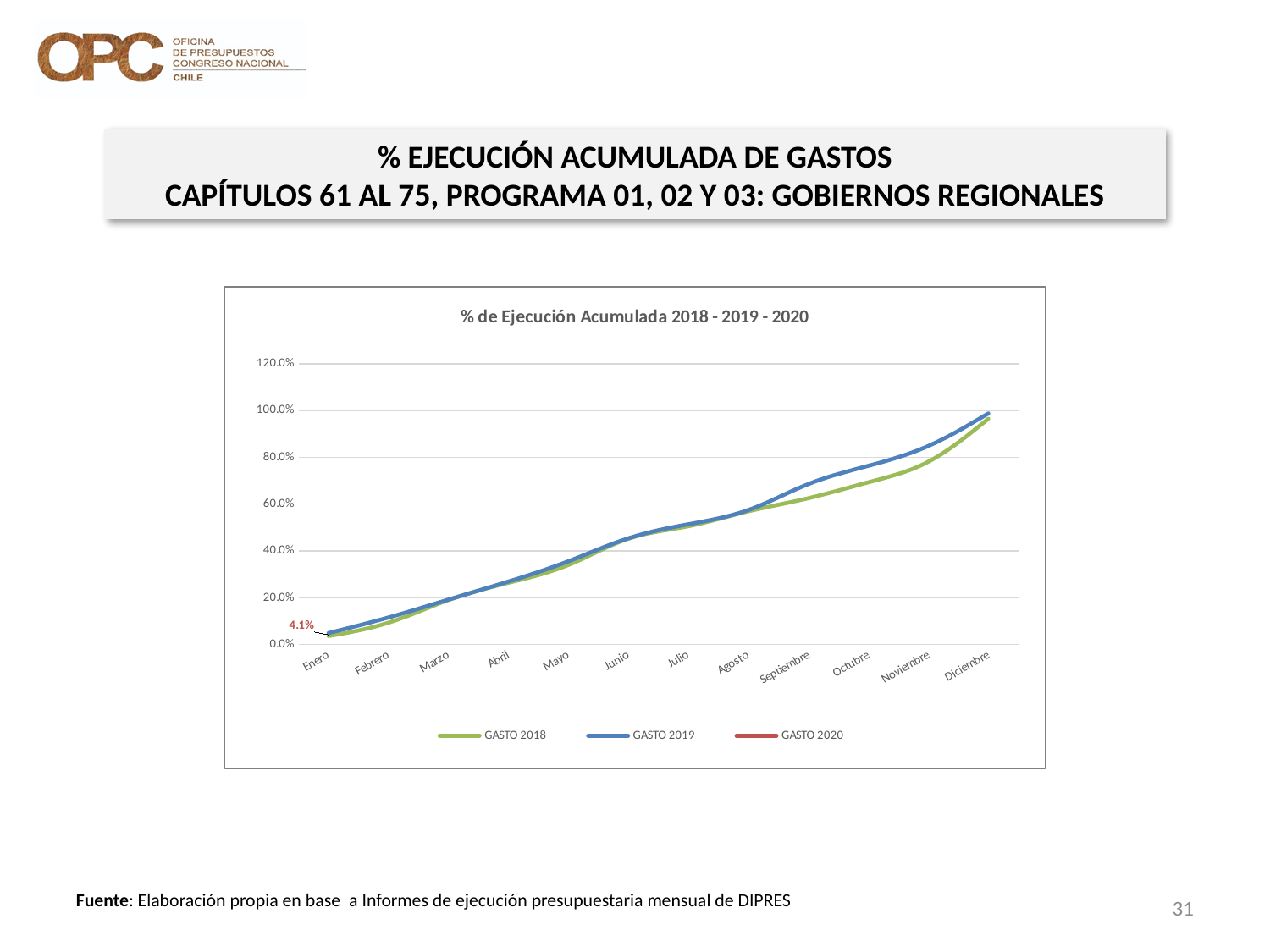
Do the GASTO 2018 and GASTO 2019 lines rise or fall from Enero to Diciembre? rise In Octubre, which series has the higher value, GASTO 2018 or GASTO 2019? GASTO 2019 What is the title of the chart? % de Ejecución Acumulada 2018 - 2019 - 2020 How many months are shown along the x axis of the chart? 12 How many series does the chart legend list? 3 Is the value for GASTO 2018 in Diciembre greater or less than 80%? greater In which month is the value for GASTO 2018 lowest? Enero Is the value for GASTO 2018 in Marzo greater or less than 40%? less What kind of chart is shown on the slide? line chart What value is printed as a data label for GASTO 2020 in Enero? 4.1% Is the value for GASTO 2019 in Octubre greater or less than 60%? greater In which month does GASTO 2019 reach its highest value? Diciembre